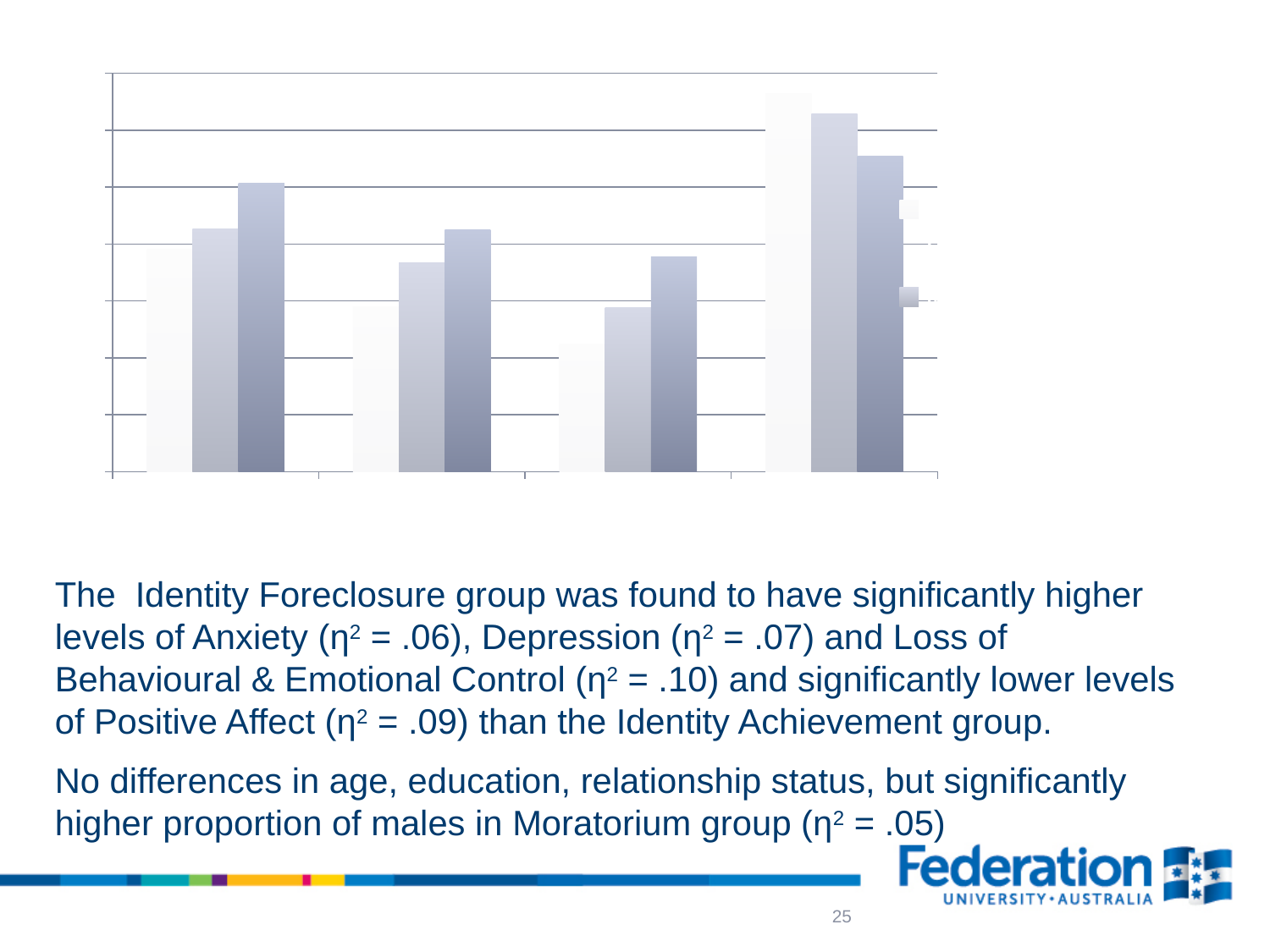
How many bars are there in each group on the chart? 3 Are the bars on the chart vertical or horizontal? vertical Does the chart display any data labels on the bars? No In the second group from the left, which bar is the tallest: the lightest, the medium, or the darkest? the darkest In the first (leftmost) group, is the lightest bar or the darkest bar taller? the darkest bar What kind of chart is shown on the slide? bar chart Which group, counting from the left, has the shortest lightest-coloured bar? the third group How many groups of bars does the chart show? 4 Which group of bars, counting from the left, contains the tallest bar on the chart? the fourth (rightmost) group In the fourth (rightmost) group, is the lightest bar or the darkest bar taller? the lightest bar